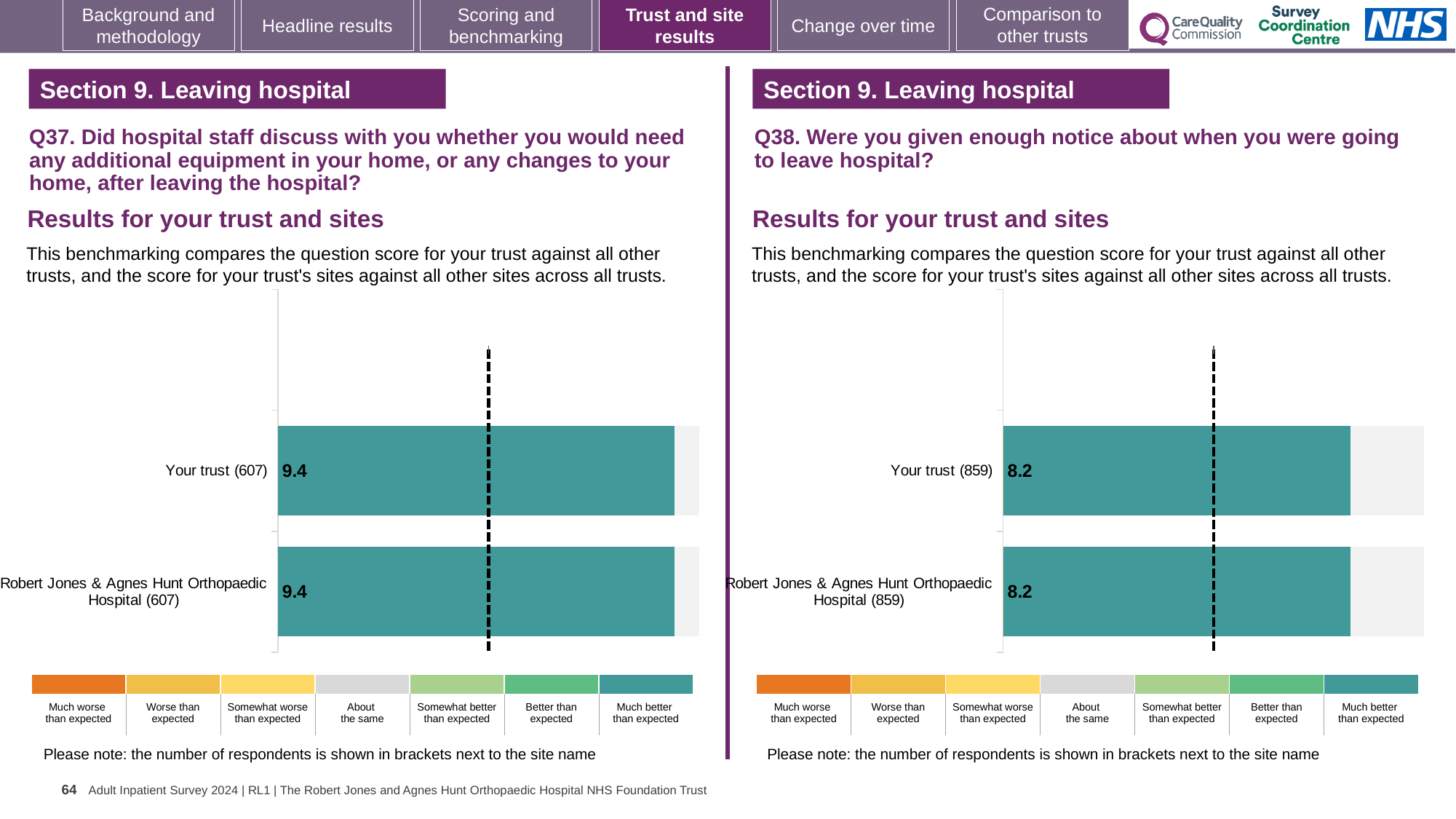
In the Q38 chart on the right, what is the score for Robert Jones & Agnes Hunt Orthopaedic Hospital? 8.2 In the Q38 chart on the right, what is the score for Your trust? 8.2 In the Q37 chart on the left, what is the difference between the score for Your trust and the score for Robert Jones & Agnes Hunt Orthopaedic Hospital? 0 How many bars are plotted in the Q37 chart on the left? 2 In the Q38 chart on the right, how many respondents are shown in brackets next to Your trust? 859 How many bars are plotted in the Q38 chart on the right? 2 In the Q37 chart on the left, what is the score for Your trust? 9.4 In the Q38 chart on the right, what is the difference between the score for Your trust and the score for Robert Jones & Agnes Hunt Orthopaedic Hospital? 0 In the Q37 chart on the left, what is the score for Robert Jones & Agnes Hunt Orthopaedic Hospital? 9.4 In the Q37 chart on the left, which benchmark category does the colour of the bars correspond to in the key below the chart? Much better than expected Which is larger: the Your trust score in the Q37 chart on the left or the Your trust score in the Q38 chart on the right? Q37 (9.4) What kind of chart is used for the Q37 results on the left? Bar chart